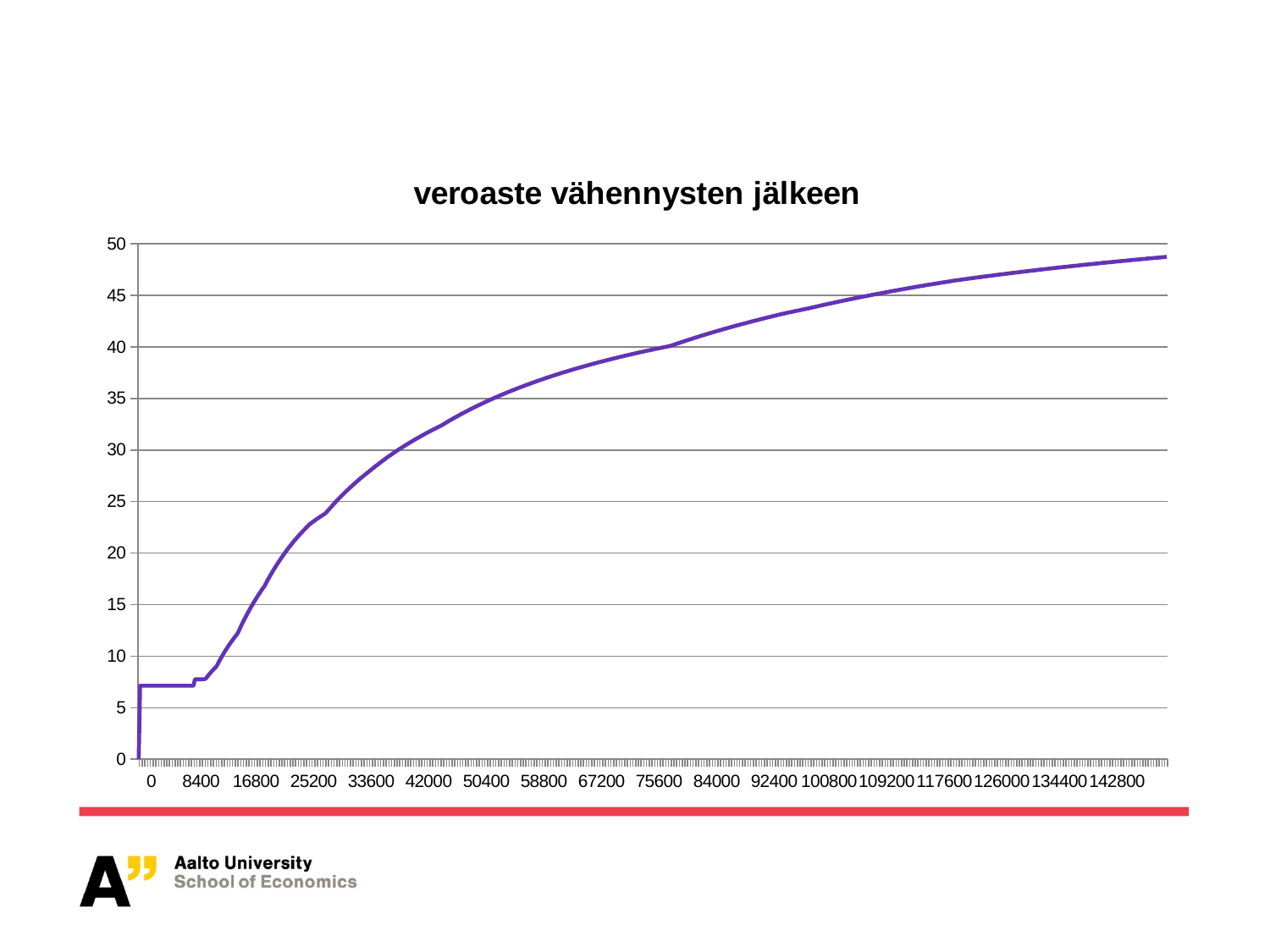
What kind of chart is shown on the slide? line chart What is the title of the chart? veroaste vähennysten jälkeen Is the value at x = 75600 greater or less than 35? greater What colour is the plotted line? purple Is the value at x = 8400 greater or less than 10? less Is the value at x = 25200 greater or less than 20? greater Do the values generally rise or fall as the x axis increases? rise